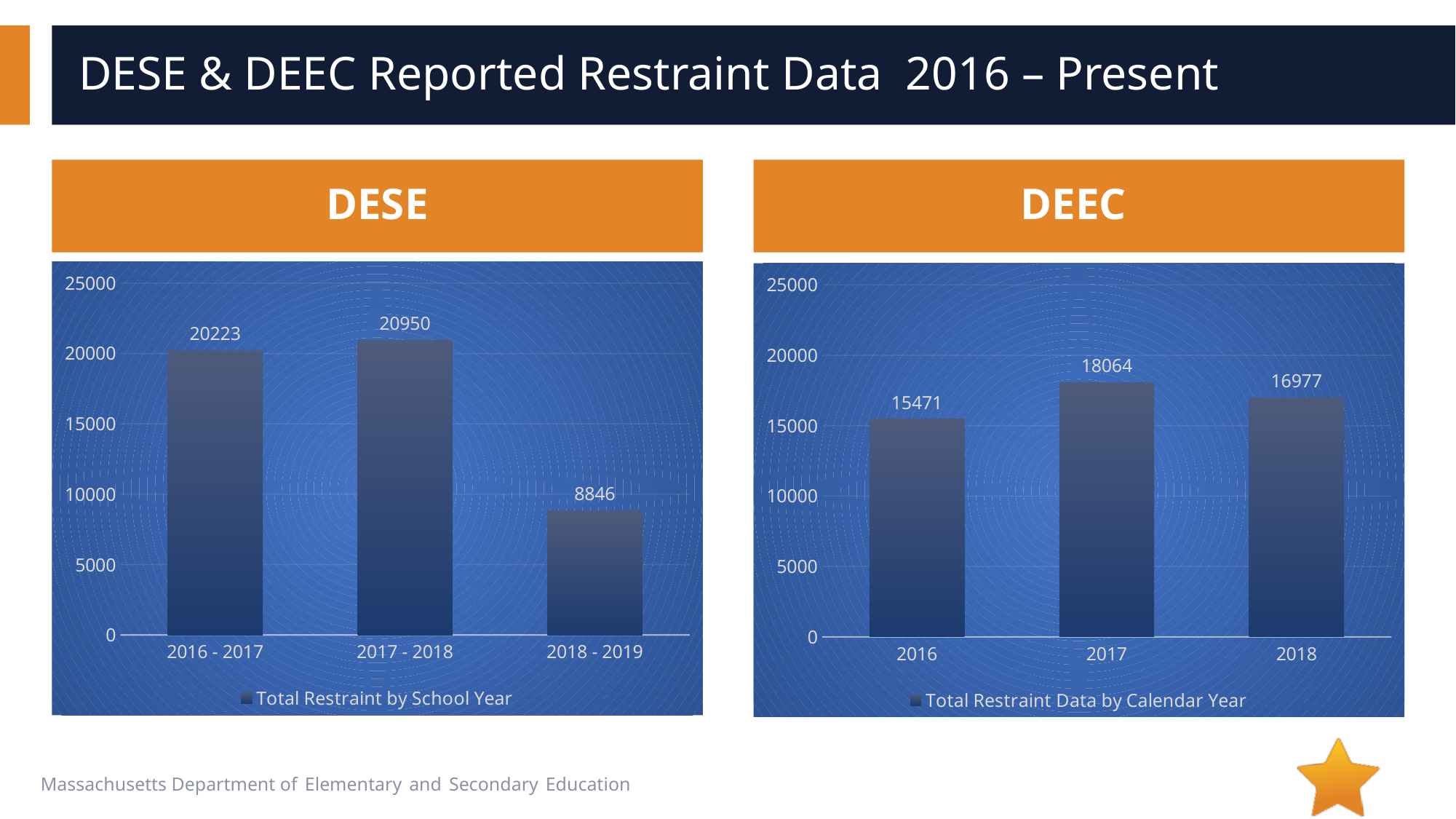
In the DESE chart, what is the total restraint value for 2018 - 2019? 8846 In the DESE chart, what is the difference between the 2017 - 2018 and 2018 - 2019 values? 12104 In the DESE chart, which school year has the highest total restraint value? 2017 - 2018 What kind of chart is the DESE chart? bar chart In the DEEC chart, which calendar year has the lowest total restraint value? 2016 In the DEEC chart, which is larger, the value for 2017 or the value for 2018? 2017 In the DESE chart, is the value for 2018 - 2019 greater or less than 10000? less In the DEEC chart, what is the difference between the 2017 and 2016 values? 2593 In the DEEC chart, what is the total restraint value for 2018? 16977 How many bars are shown in the DEEC chart? 3 In the DEEC chart, what is the total restraint value for 2017? 18064 In the DESE chart, what is the total restraint value for 2016 - 2017? 20223